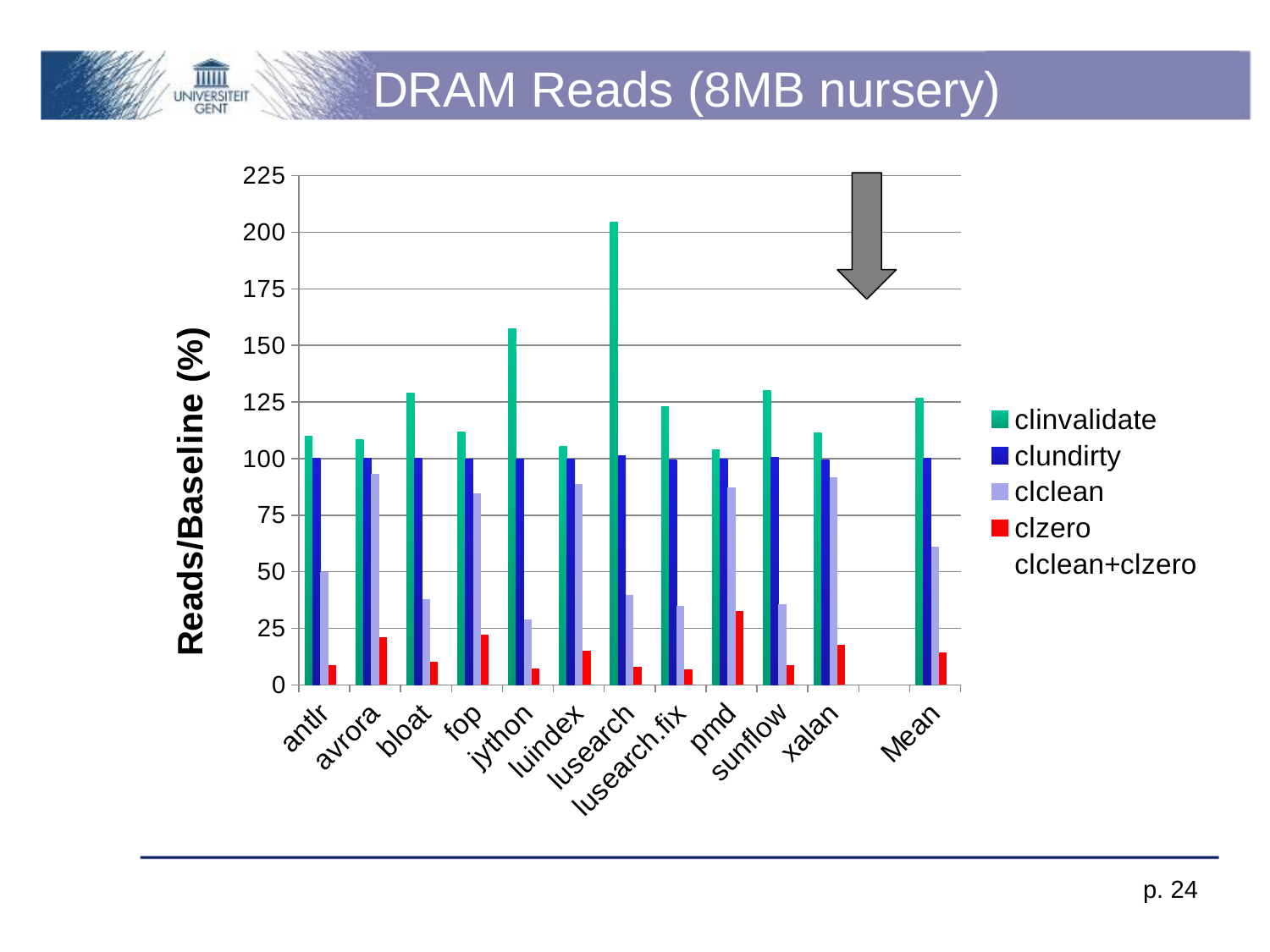
Is the clinvalidate value for jython greater or less than 150? greater Which category has the highest clzero value? pmd Is the clinvalidate value for lusearch greater or less than 175? greater Is the clclean value for bloat greater or less than 50? less What is the title of the y axis? Reads/Baseline (%) Which category has the highest clinvalidate value? lusearch How many categories are shown along the x axis of the chart? 12 Which is larger, the clinvalidate value for jython or for lusearch? lusearch What kind of chart is shown on the slide? bar chart Which category has the lowest clclean value? jython Which is larger, the clclean value for avrora or for bloat? avrora